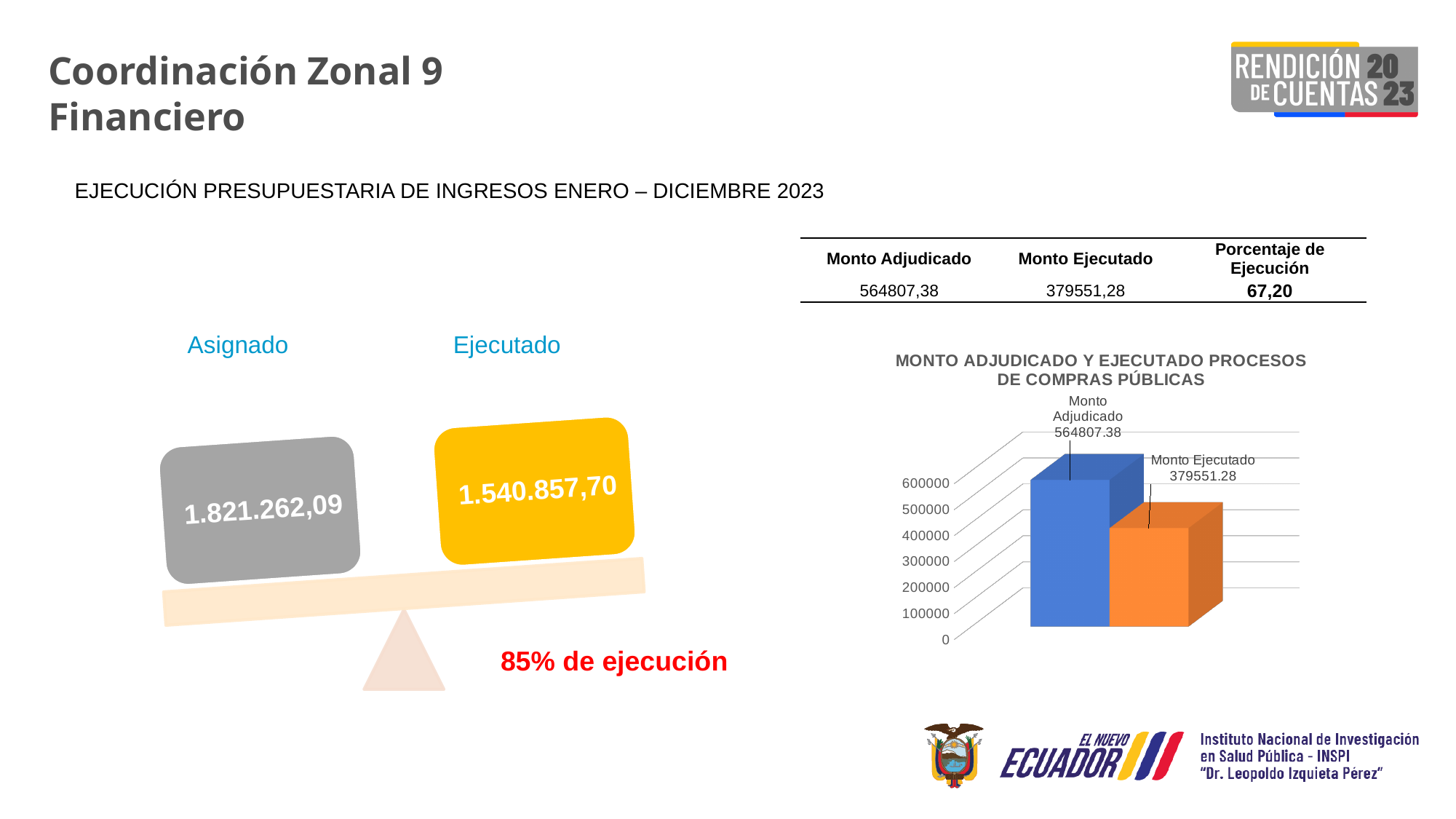
Which is larger in the chart, Monto Adjudicado or Monto Ejecutado? Monto Adjudicado Is the value for Monto Ejecutado greater or less than 400000? less Which bar in the chart has the lowest value? Monto Ejecutado What is the title of the chart on the slide? MONTO ADJUDICADO Y EJECUTADO PROCESOS DE COMPRAS PÚBLICAS Which bar in the chart has the highest value? Monto Adjudicado What is the value of the Monto Adjudicado bar in the chart? 564807.38 What is the difference between the Monto Adjudicado and Monto Ejecutado values in the chart? 185256.10 What kind of chart is shown on the slide? Bar chart Do the values in the chart rise or fall from the left bar to the right bar? Fall How many bars are plotted in the chart? 2 What is the value of the Monto Ejecutado bar in the chart? 379551.28 Is the value for Monto Adjudicado greater or less than 500000? greater